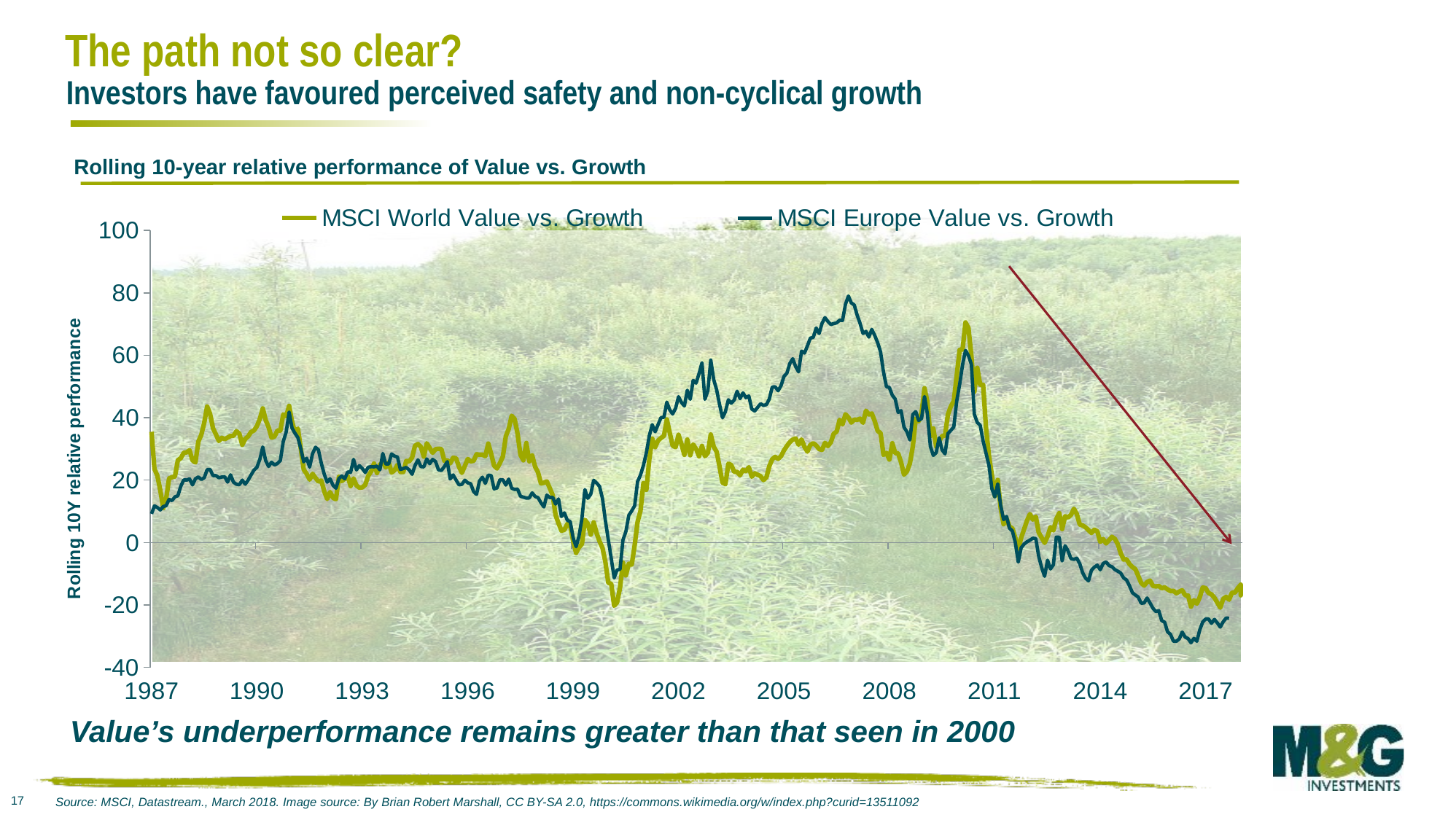
At the right-hand end of the chart (after 2017), which series has the higher value: MSCI World Value vs. Growth or MSCI Europe Value vs. Growth? MSCI World Value vs. Growth Is the peak value of MSCI World Value vs. Growth around 2010 greater or less than 60? greater Is the peak value of MSCI Europe Value vs. Growth around 2007 greater or less than 60? greater What is the label on the vertical axis of the chart? Rolling 10Y relative performance What kind of chart is shown on the slide? Line chart How many series does the legend list? 2 What is the title of the chart? Rolling 10-year relative performance of Value vs. Growth Is the value of MSCI World Value vs. Growth at its low point around 2000 greater or less than 0? less Between 2011 and 2017, does the MSCI World Value vs. Growth line generally rise or fall? fall Between 2000 and 2007, does the MSCI Europe Value vs. Growth line generally rise or fall? rise Around 2007, which series has the higher value: MSCI World Value vs. Growth or MSCI Europe Value vs. Growth? MSCI Europe Value vs. Growth